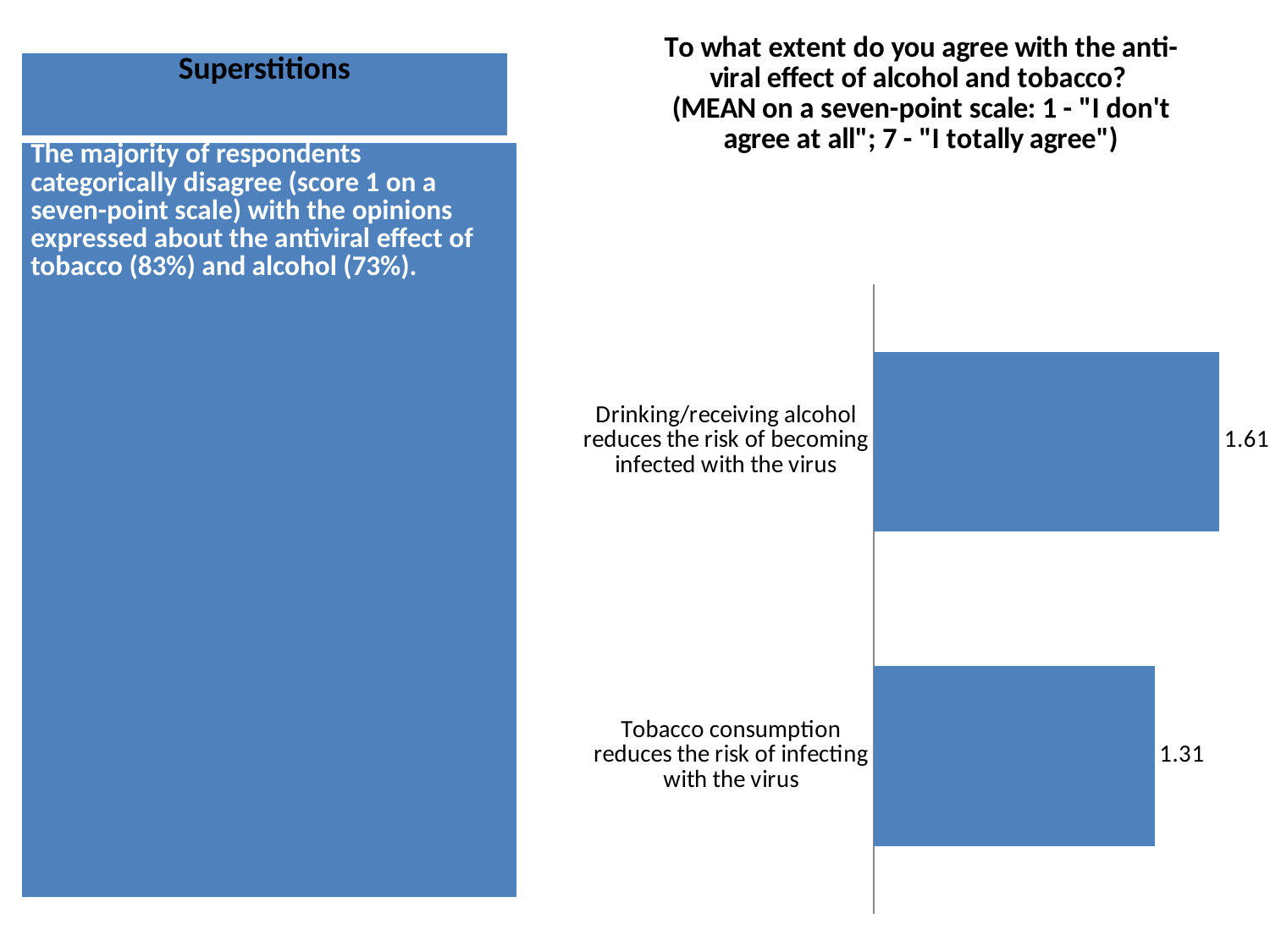
What is the difference between the mean scores for the alcohol statement and the tobacco statement? 0.30 Is the mean score for the alcohol statement larger or smaller than the mean score for the tobacco statement? larger What is the mean agreement score for "Drinking/receiving alcohol reduces the risk of becoming infected with the virus"? 1.61 What type of chart is shown on the slide? bar chart Which statement has the higher mean agreement score? Drinking/receiving alcohol reduces the risk of becoming infected with the virus What is the mean agreement score for "Tobacco consumption reduces the risk of infecting with the virus"? 1.31 What colour are the bars in the chart? blue What is the title of the chart? To what extent do you agree with the anti-viral effect of alcohol and tobacco? (MEAN on a seven-point scale: 1 - "I don't agree at all"; 7 - "I totally agree") Which statement has the lower mean agreement score? Tobacco consumption reduces the risk of infecting with the virus How many statements (categories) are shown in the chart? 2